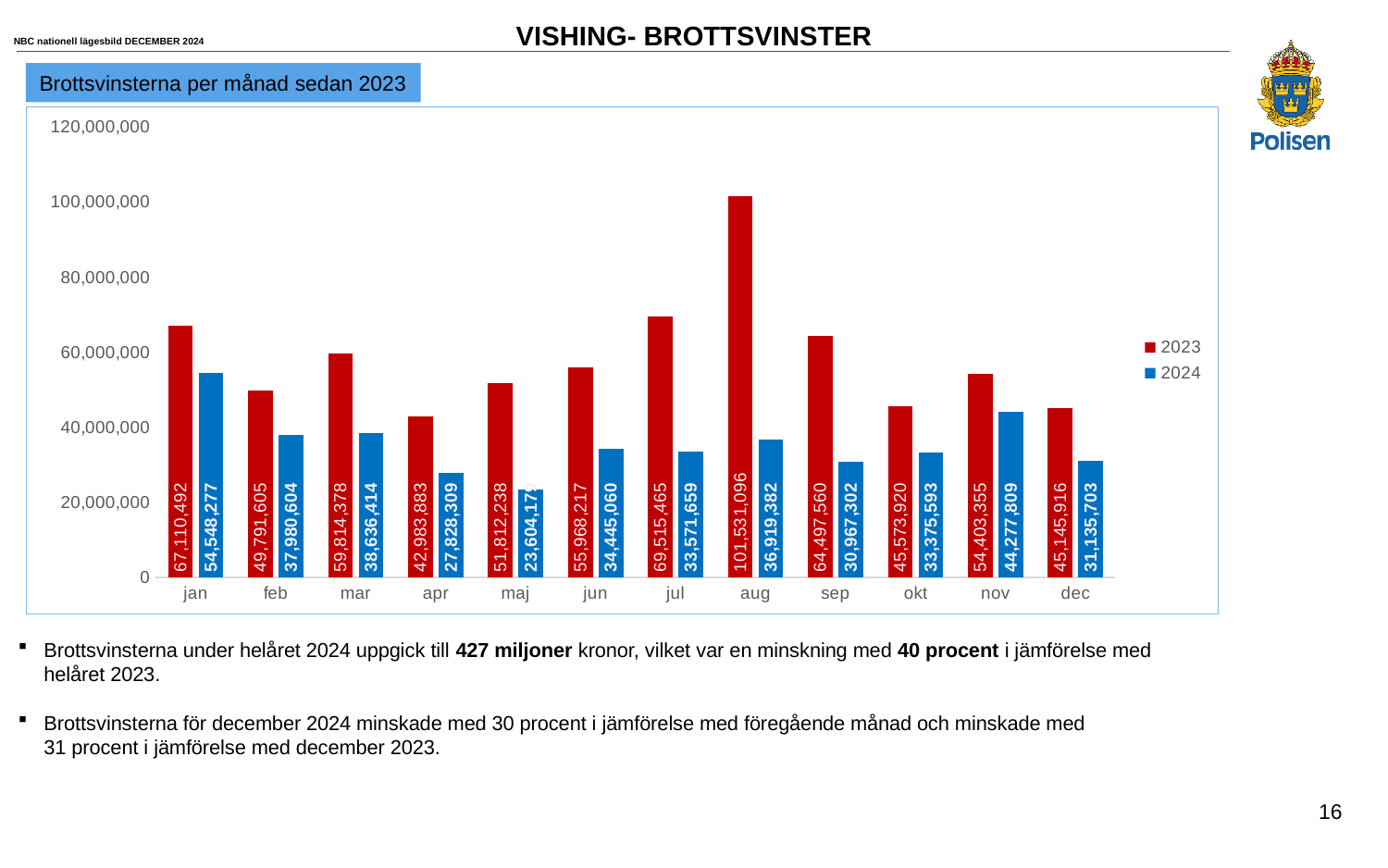
What is the value for 2023 in dec? 45,145,916 What is the value for 2024 in nov? 44,277,809 Is the value for 2024 in maj greater or less than 20,000,000? greater Which is larger in jul: the 2023 value or the 2024 value? 2023 What is the value for 2024 in jan? 54,548,277 How many months are shown on the x axis? 12 What is the difference between the 2023 and 2024 values in dec? 14,010,213 What is the value for 2023 in aug? 101,531,096 Which month has the highest value for the 2023 series? aug What kind of chart is shown on the slide? bar chart Which month has the lowest value for the 2024 series? maj How many series does the legend list? 2